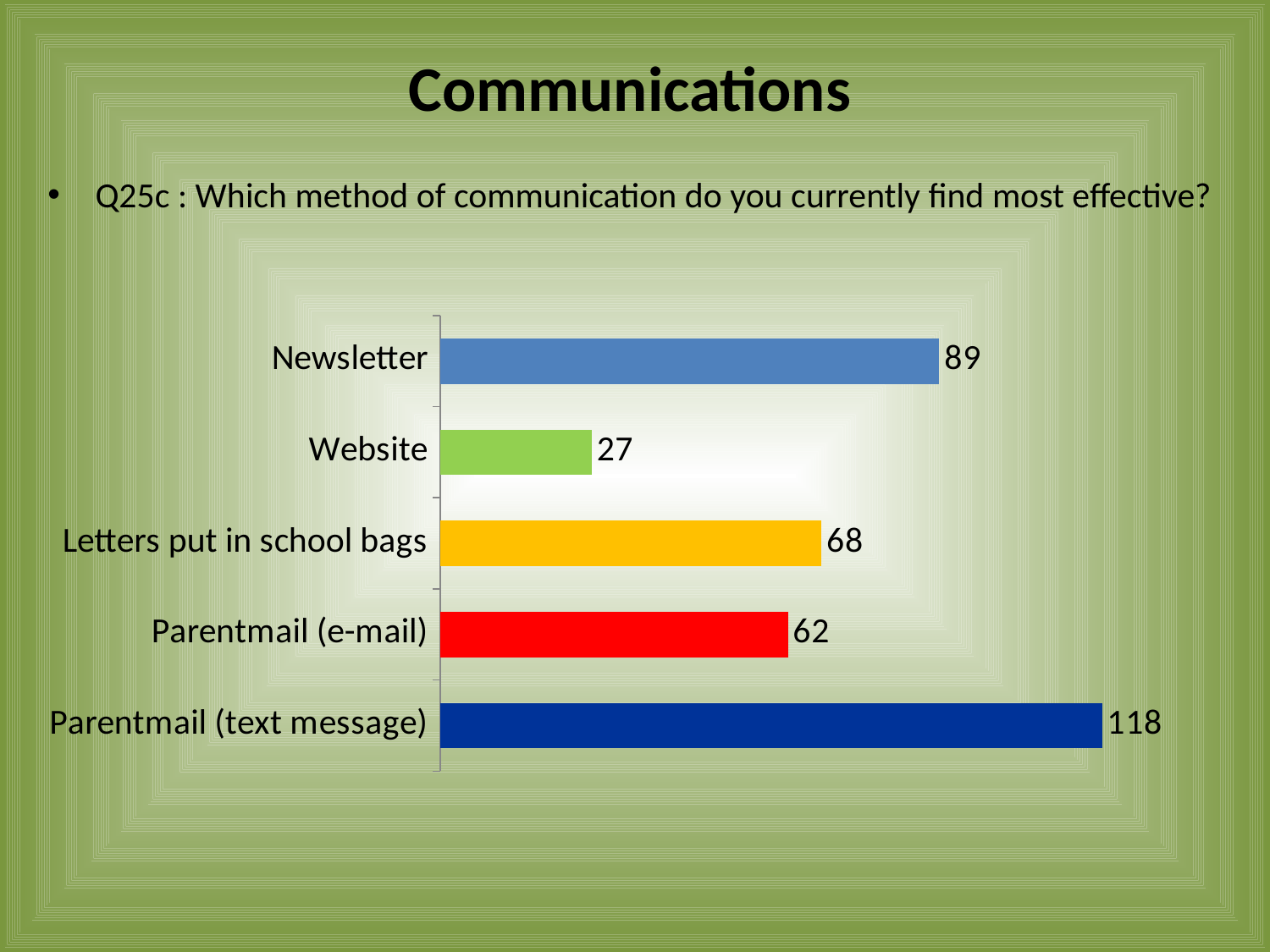
How many categories are shown in the chart? 5 What is the value for Parentmail (text message)? 118 Which category has the highest value? Parentmail (text message) Which category has the lowest value? Website Which is larger, the value for Newsletter or the value for Letters put in school bags? Newsletter What is the value for Newsletter? 89 What is the value for Letters put in school bags? 68 What is the value for Parentmail (e-mail)? 62 What is the difference between the values for Letters put in school bags and Parentmail (e-mail)? 6 What is the difference between the values for Parentmail (text message) and Newsletter? 29 What kind of chart is shown on the slide? Bar chart What is the value for Website? 27